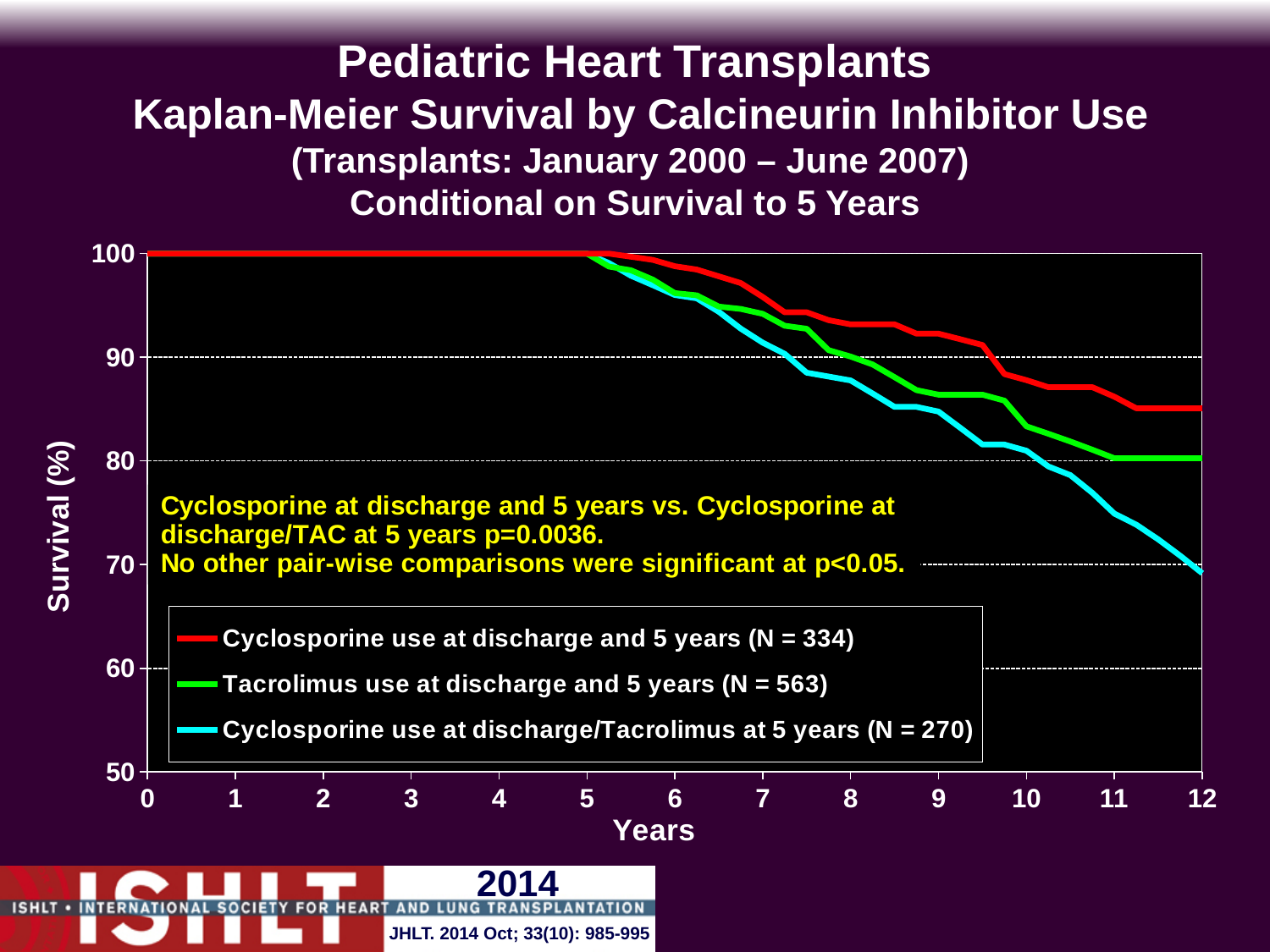
Is the survival for the 'Cyclosporine use at discharge/Tacrolimus at 5 years' group at 11 years greater or less than 80%? less What kind of chart is shown on the slide? line chart Is the survival for the 'Cyclosporine use at discharge and 5 years' group at 12 years greater or less than 80%? greater Is the survival for the 'Cyclosporine use at discharge/Tacrolimus at 5 years' group at 8 years greater or less than 90%? less How many series does the legend list? 3 What is the N for the 'Cyclosporine use at discharge/Tacrolimus at 5 years' group shown in the legend? N = 270 Which group has the lowest survival at 12 years? Cyclosporine use at discharge/Tacrolimus at 5 years What is the N for the 'Tacrolimus use at discharge and 5 years' group shown in the legend? N = 563 Do the survival curves rise or fall as years increase beyond 5? fall Which group has the highest survival at 12 years? Cyclosporine use at discharge and 5 years What is the N for the 'Cyclosporine use at discharge and 5 years' group shown in the legend? N = 334 What p-value is given for Cyclosporine at discharge and 5 years vs. Cyclosporine at discharge/TAC at 5 years? p=0.0036